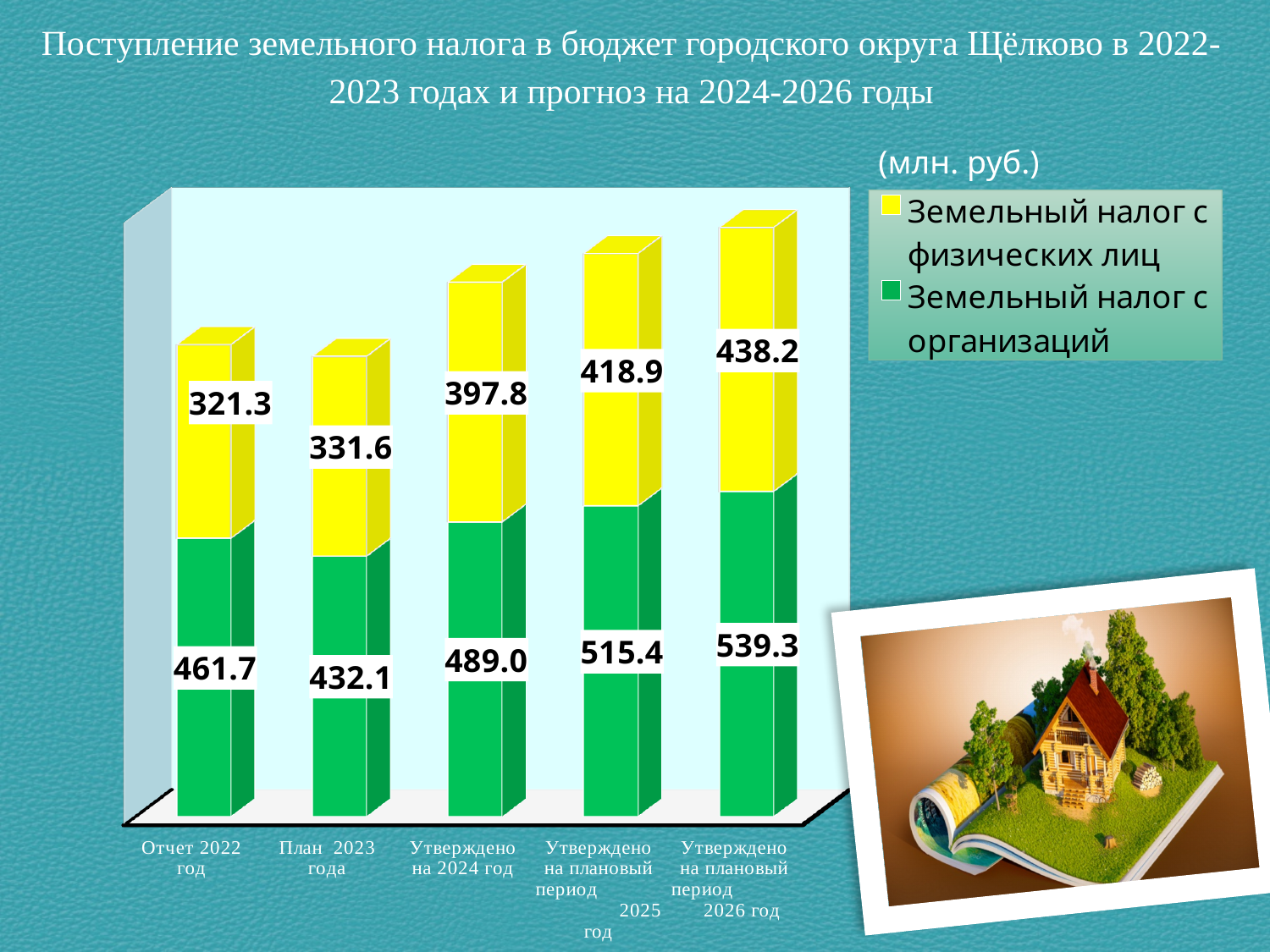
What kind of chart is shown on the slide? Stacked bar chart Which is larger for 'Утверждено на плановый период 2025 год': 'Земельный налог с физических лиц' or 'Земельный налог с организаций'? Земельный налог с организаций How many categories are shown on the x axis? 5 Which category has the highest value for 'Земельный налог с физических лиц'? Утверждено на плановый период 2026 год How many series does the legend list? 2 Which category has the lowest value for 'Земельный налог с организаций'? План 2023 года What unit of measurement is indicated next to the legend? млн. руб. What is the total of the stacked bar for 'Утверждено на плановый период 2026 год'? 977.5 What is the value of 'Земельный налог с физических лиц' for 'Отчет 2022 год'? 321.3 What is the value of 'Земельный налог с организаций' for 'Утверждено на плановый период 2026 год'? 539.3 What is the difference between 'Земельный налог с организаций' and 'Земельный налог с физических лиц' for 'Утверждено на 2024 год'? 91.2 What is the value of 'Земельный налог с организаций' for 'План 2023 года'? 432.1